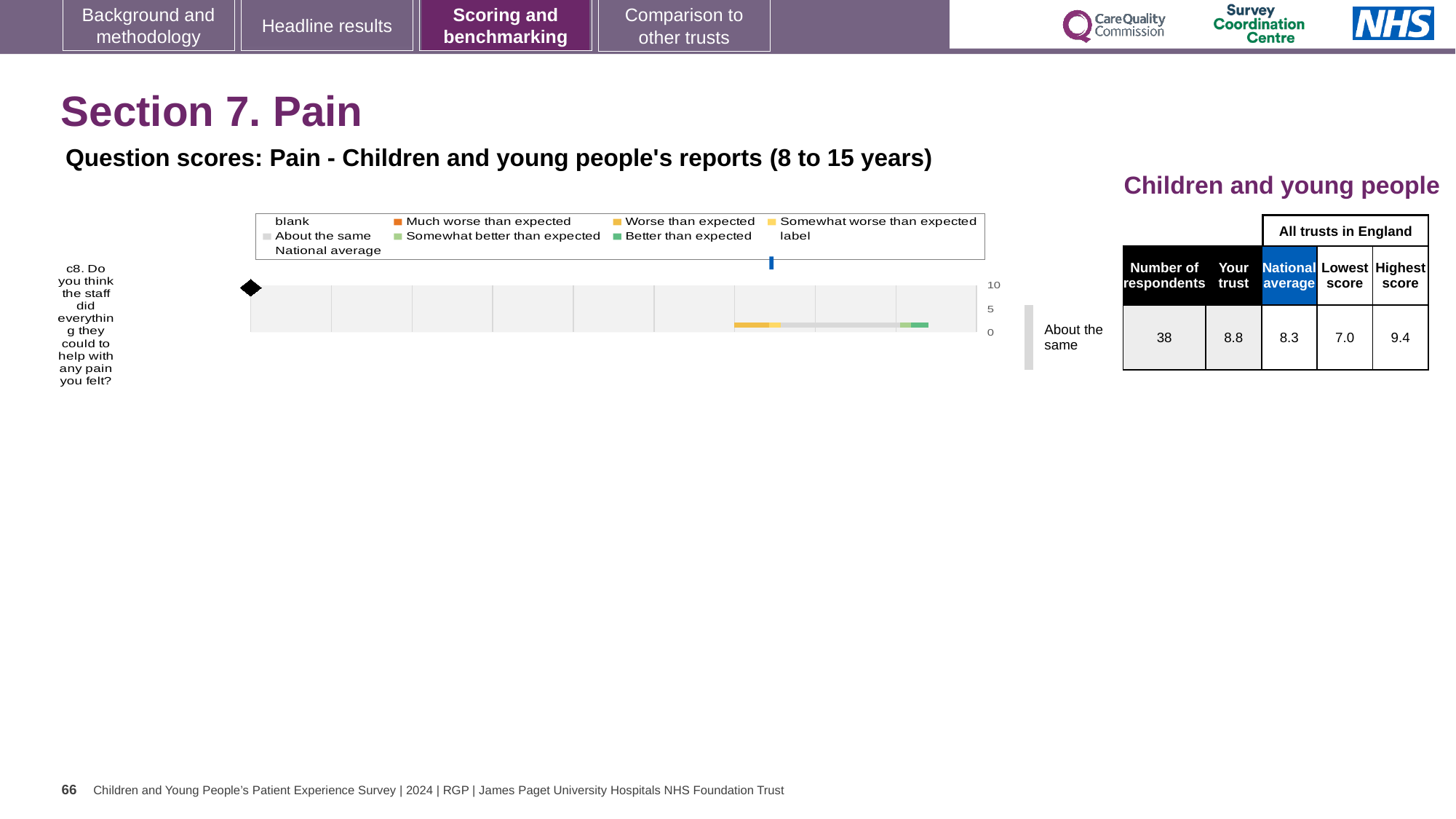
Which benchmark category is the trust's result for question c8 assigned to? About the same How many respondents answered question c8? 38 What is the highest score among all trusts in England for question c8? 9.4 Is the trust's score for question c8 higher or lower than the national average? higher What is the difference between the highest and lowest scores for question c8? 2.4 What is the national average score for question c8? 8.3 What is the difference between the trust's score and the national average for question c8? 0.5 What is the maximum value shown on the chart's score axis? 10 What is the lowest score among all trusts in England for question c8? 7.0 What kind of chart is shown for question c8 on the slide? bar chart What is the 'Your trust' score for question c8 about staff helping with pain? 8.8 How many survey questions are plotted in the chart? 1